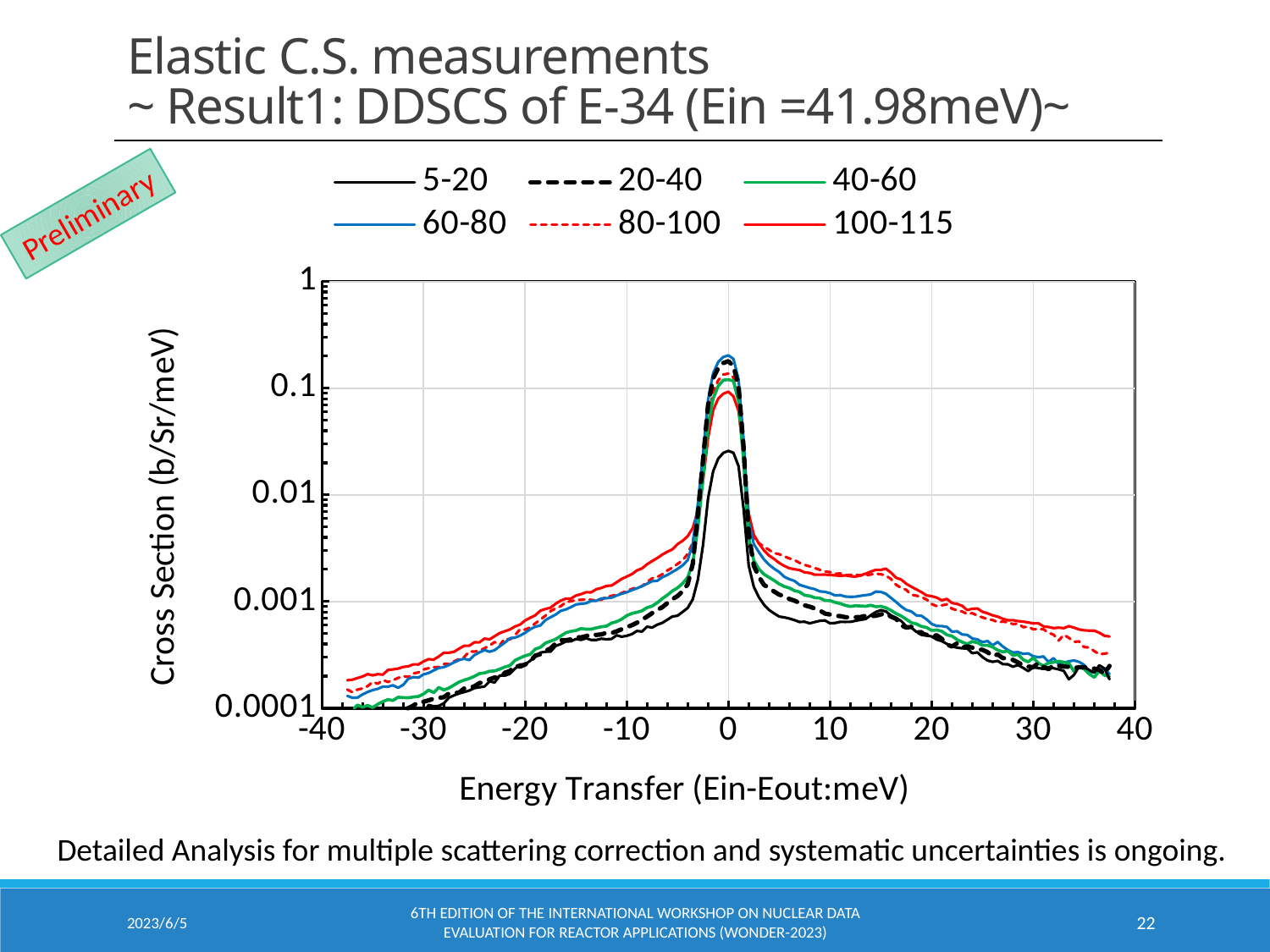
Is the peak value of the 60-80 series at an energy transfer of 0 greater or less than 0.1? greater Is the value of the 5-20 series at an energy transfer of -30 greater or less than 0.001? less How many series does the legend list? 6 At an energy transfer of -30, which series has the larger value, 100-115 or 5-20? 100-115 What is the label of the x axis? Energy Transfer (Ein-Eout:meV) Is the value of the 100-115 series at an energy transfer of 30 greater or less than 0.0001? greater What is the label of the y axis? Cross Section (b/Sr/meV) Which series has the lowest peak value at an energy transfer of 0? 5-20 Do the values of the 60-80 series rise or fall as the energy transfer goes from -40 to 0? rise What kind of chart is shown on the slide? line chart